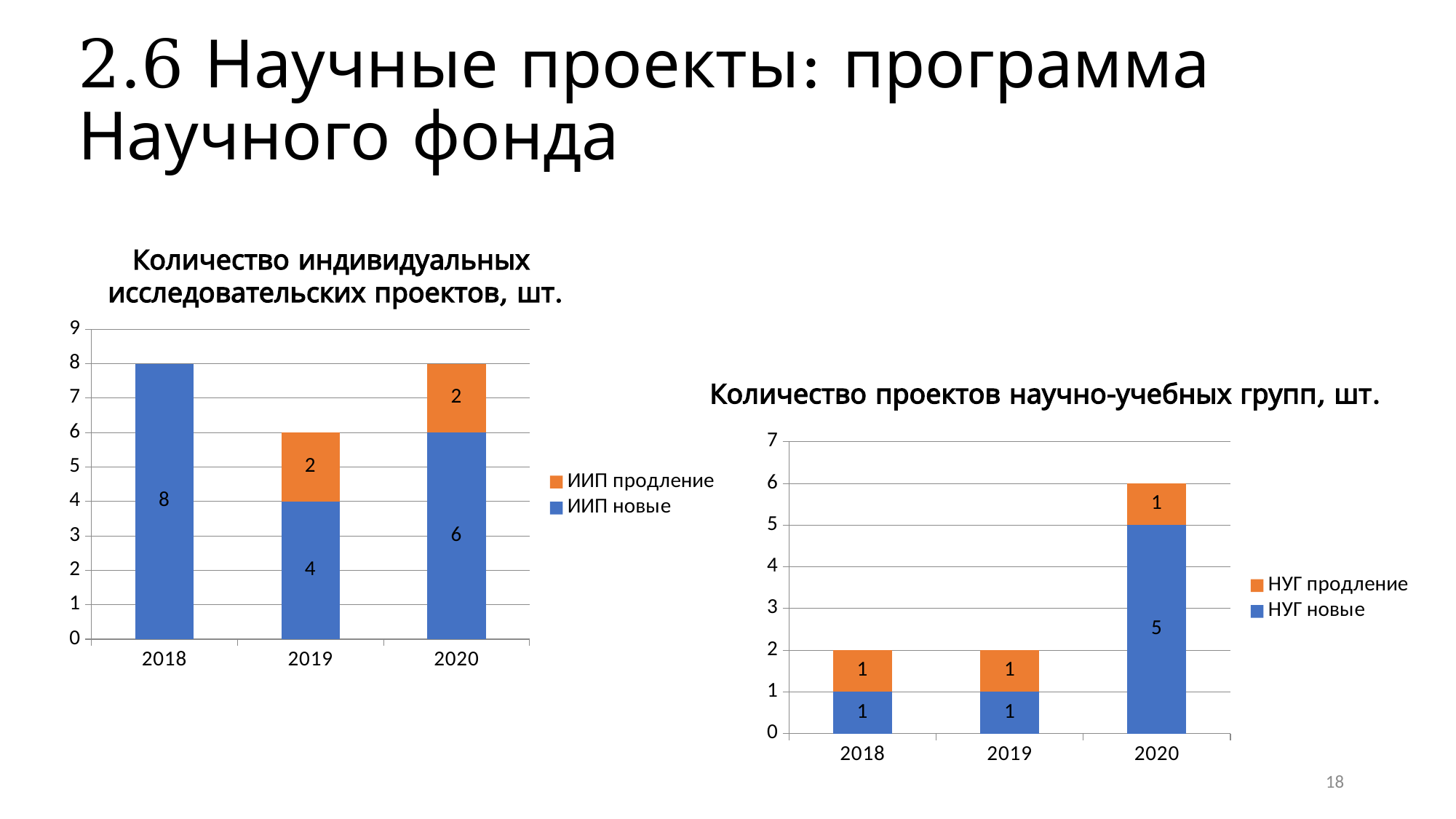
In the chart 'Количество индивидуальных исследовательских проектов, шт.', what is the total height of the stacked bar for 2019? 6 In the chart 'Количество индивидуальных исследовательских проектов, шт.', how many series does the legend list? 2 What type of chart is 'Количество проектов научно-учебных групп, шт.'? Stacked bar chart In the chart 'Количество индивидуальных исследовательских проектов, шт.', what is the value of 'ИИП новые' for 2018? 8 In the chart 'Количество индивидуальных исследовательских проектов, шт.', what is the difference between 'ИИП новые' in 2018 and 2020? 2 In the chart 'Количество проектов научно-учебных групп, шт.', is 'НУГ новые' larger in 2019 or in 2020? 2020 In the chart 'Количество проектов научно-учебных групп, шт.', how many years are shown on the x axis? 3 In the chart 'Количество проектов научно-учебных групп, шт.', what is the value of 'НУГ новые' for 2020? 5 In the chart 'Количество индивидуальных исследовательских проектов, шт.', what is the value of 'ИИП продление' for 2019? 2 In the chart 'Количество проектов научно-учебных групп, шт.', what is the total height of the stacked bar for 2020? 6 In the chart 'Количество индивидуальных исследовательских проектов, шт.', which year has the lowest value for 'ИИП новые'? 2019 In the chart 'Количество проектов научно-учебных групп, шт.', which year has the highest value for 'НУГ новые'? 2020